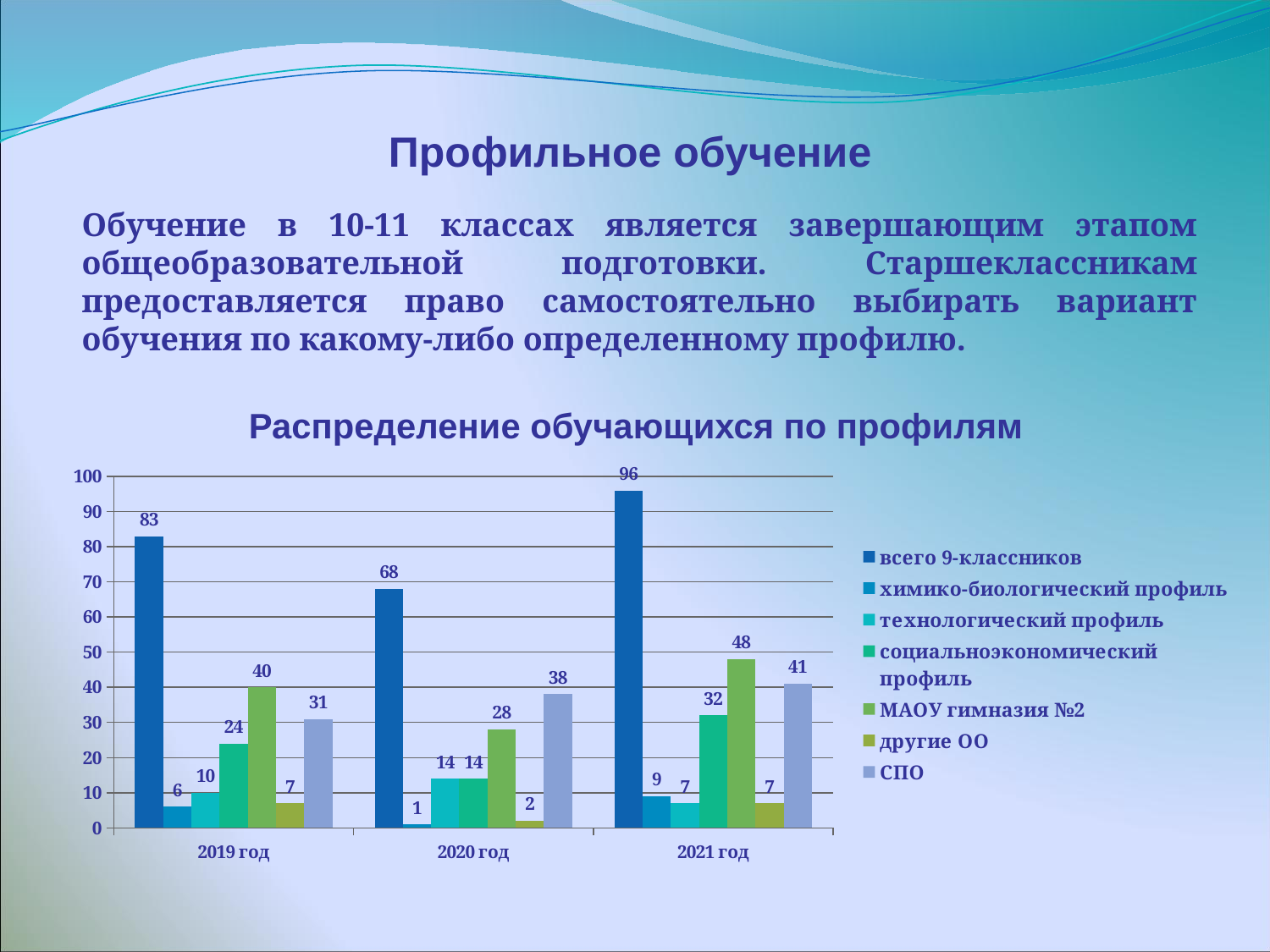
What is the value for «химико-биологический профиль» in 2020 год? 1 In which year is the value for «другие ОО» lowest? 2020 год What is the value for «всего 9-классников» in 2019 год? 83 Which is larger: «социальноэкономический профиль» in 2021 год or «СПО» in 2021 год? СПО What kind of chart is shown on the slide? bar chart Does the value for «СПО» rise or fall from 2019 год to 2021 год? rise How many year categories are shown on the x axis? 3 What is the difference between «всего 9-классников» in 2021 год and in 2020 год? 28 What is the value for «МАОУ гимназия №2» in 2021 год? 48 What is the value for «СПО» in 2020 год? 38 In which year is the value for «всего 9-классников» highest? 2021 год How many series does the legend list? 7